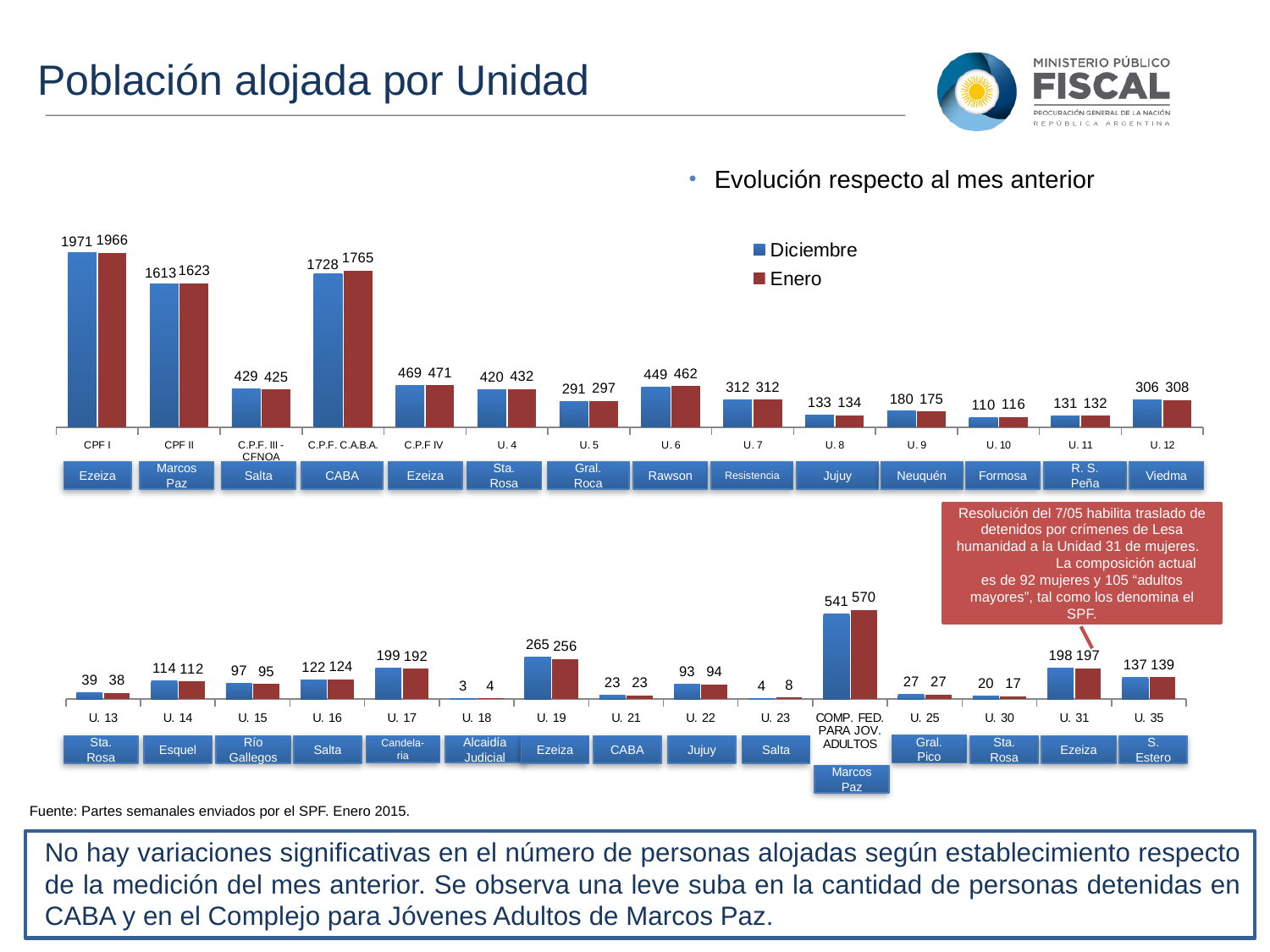
In the top chart, what is the difference between the Enero and Diciembre values for C.P.F. C.A.B.A.? 37 In the bottom chart, which category has the lowest Diciembre value? U. 18 In the bottom chart, what is the difference between the Diciembre and Enero values for U. 23? 4 What type of chart is the top chart? Bar chart How many categories are shown in the bottom chart? 15 In the bottom chart, which is larger for U. 19: the Diciembre value or the Enero value? Diciembre In the top chart, what is the Enero value for C.P.F. C.A.B.A.? 1765 In the top chart, which category has the highest Diciembre value? CPF I In the top chart, which category has the lowest Enero value? U. 10 In the top chart, what is the Diciembre value for U. 9? 180 In the bottom chart, what is the Enero value for COMP. FED. PARA JOV. ADULTOS? 570 How many series does the legend of the top chart list? 2